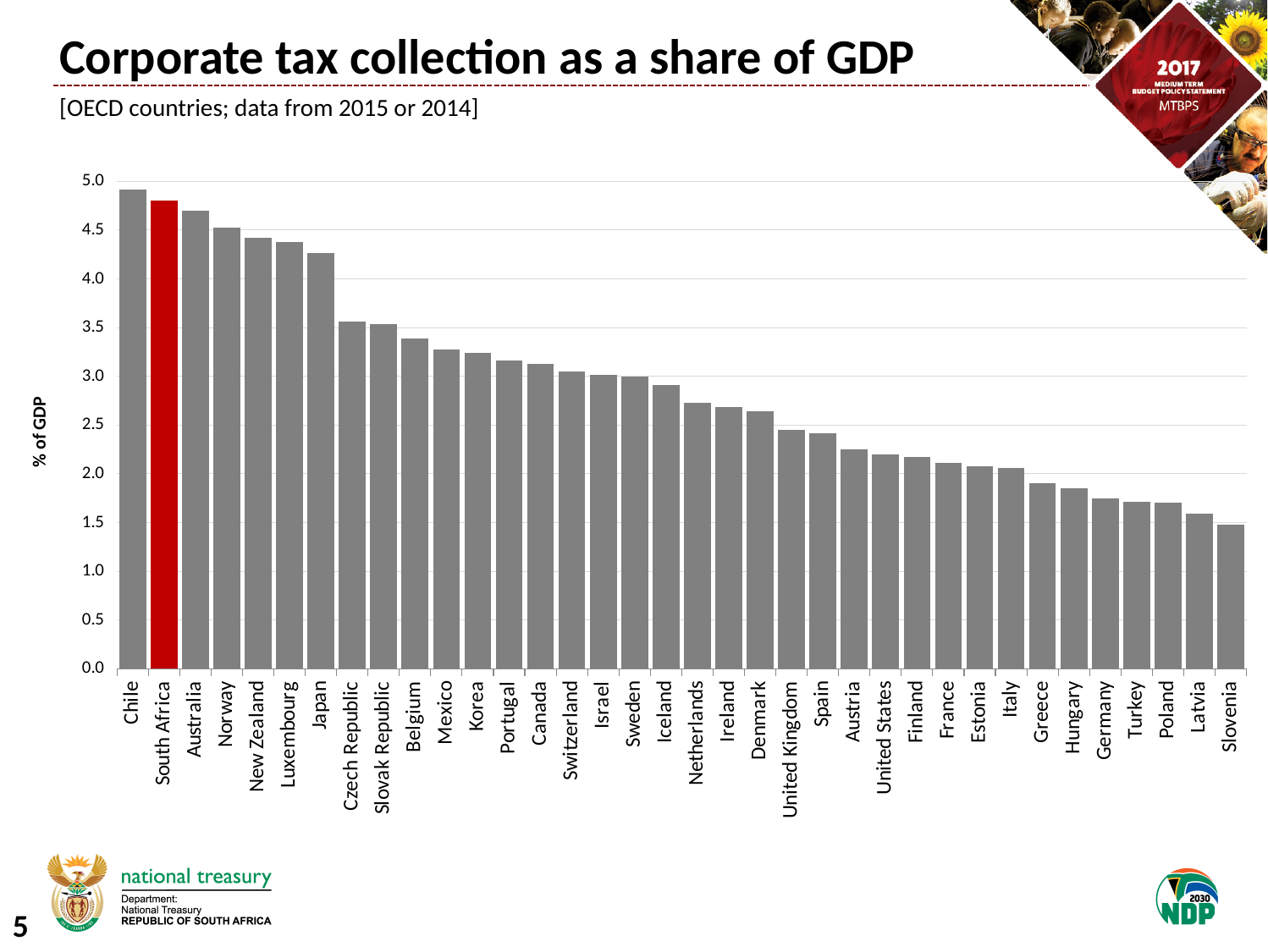
Is the value for Belgium greater or less than 3.5? less Which country has the lowest corporate tax collection as a share of GDP? Slovenia Which country has the highest corporate tax collection as a share of GDP? Chile Which has a larger value, Japan or Belgium? Japan Is the value for Netherlands greater or less than 2.5? greater Is the value for Japan greater or less than 4.0? greater Which country's bar is highlighted in red? South Africa Do the values rise or fall moving from left to right along the x axis? fall How many countries are shown in the chart? 36 What kind of chart is shown on the slide? bar chart